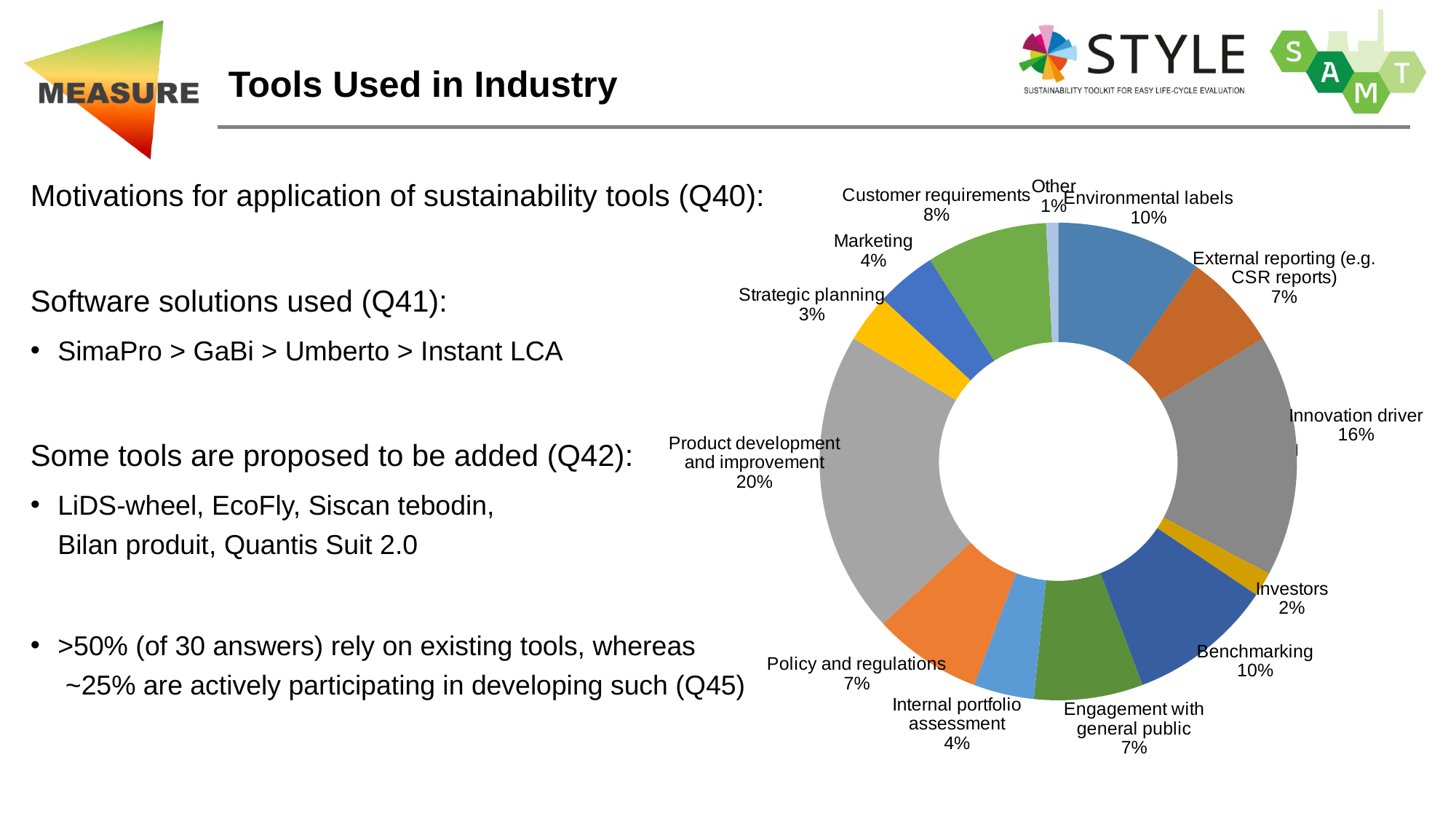
What share does Strategic planning have in the chart? 3% What is the difference in share between Product development and improvement and Innovation driver? 4% Which category has the largest share in the chart? Product development and improvement How many categories are shown in the chart? 13 What share does Customer requirements have in the chart? 8% What share does Innovation driver have in the chart? 16% What share does Product development and improvement have in the chart? 20% What share does Investors have in the chart? 2% Which has a larger share, Benchmarking or Marketing? Benchmarking What kind of chart is shown on the slide? Doughnut (pie) chart What is the combined share of Environmental labels and Benchmarking? 20% Which category has the smallest share in the chart? Other